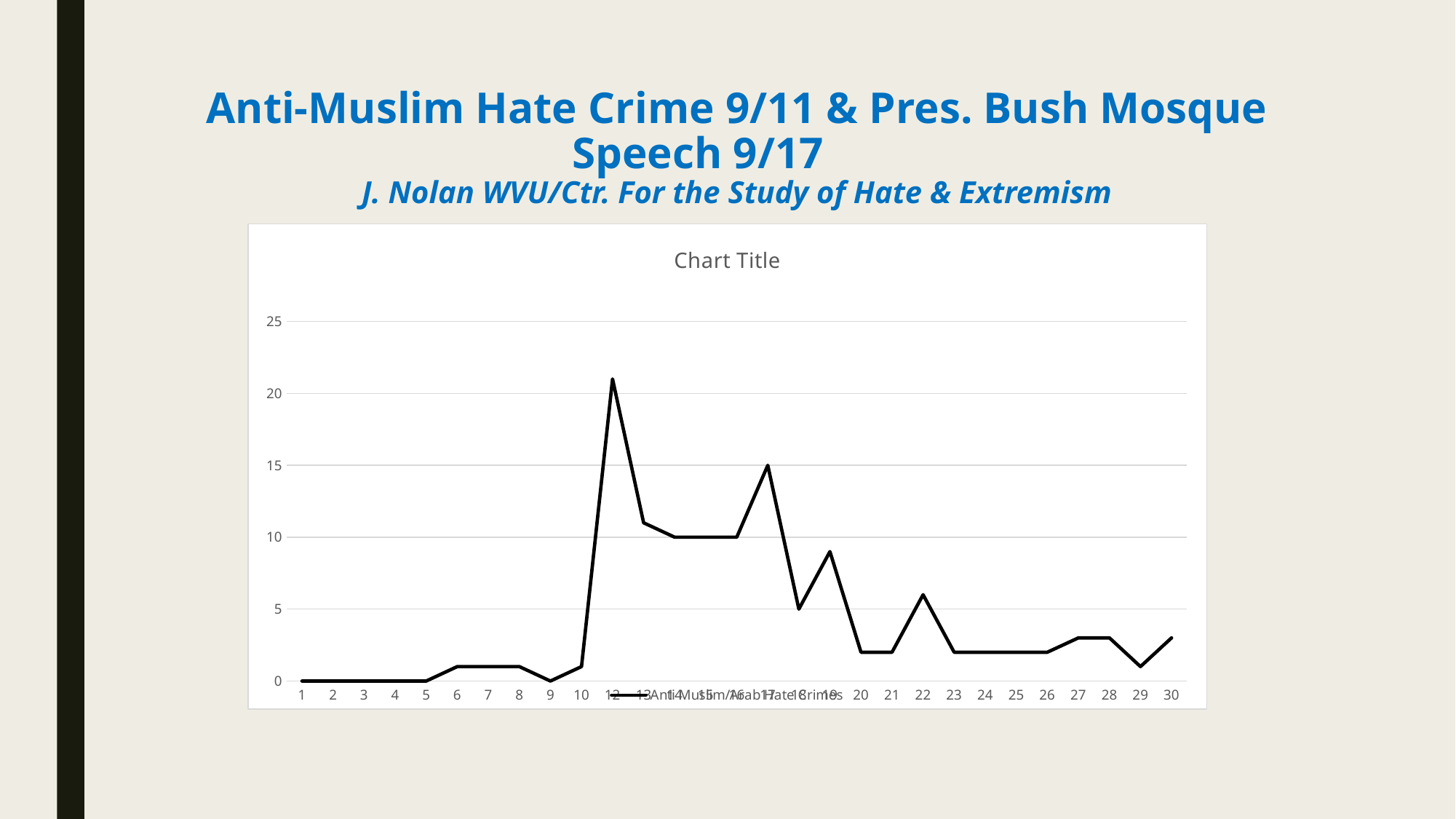
What is the value at point 16? 10 Is the value at point 12 greater or less than 20? greater What is the value at point 18? 5 Is the value at point 30 greater or less than 5? less What is the value at point 1? 0 What is the title printed inside the chart area? Chart Title Which has the larger value, point 12 or point 18? point 12 How many points are plotted along the x axis? 29 What kind of chart is shown on the slide? line chart How many series does the legend list? 1 At which x-axis point does the line reach its highest value? 12